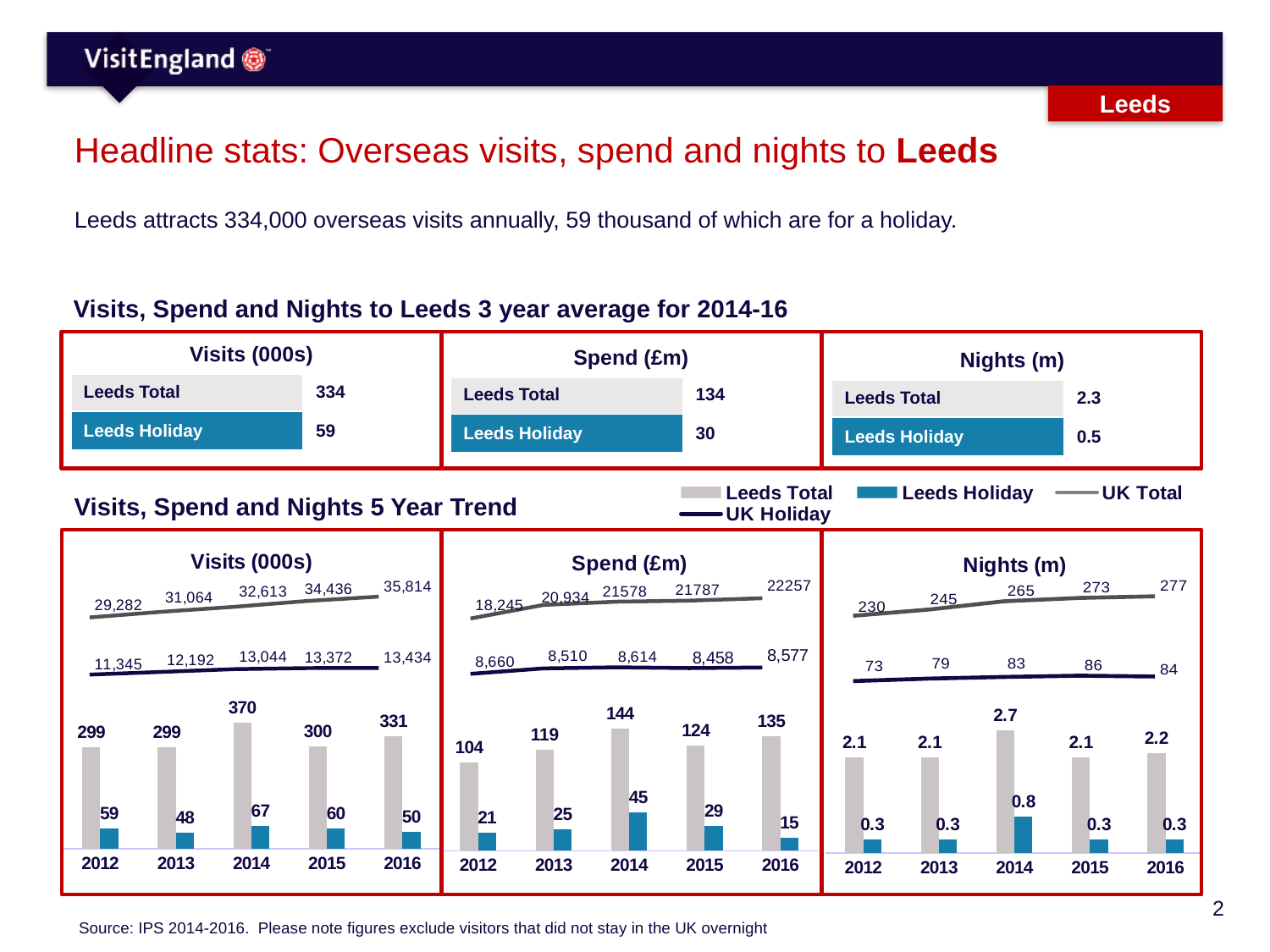
In the Visits (000s) trend chart, what is the Leeds Total value for 2014? 370 In the Nights (m) trend chart, what is the UK Holiday value for 2012? 73 In the Nights (m) trend chart, what is the UK Total value for 2015? 273 What kind of chart is used for the Leeds Total and Leeds Holiday series in the Spend (£m) trend chart? Bar chart How many years are shown on the x axis of the Visits (000s) trend chart? 5 In the Visits (000s) trend chart, which year has the lowest Leeds Holiday visits? 2013 In the Visits (000s) trend chart, does the UK Total line rise or fall from 2012 to 2016? Rise In the Spend (£m) trend chart, which year has the highest Leeds Total spend? 2014 In the Spend (£m) trend chart, what is the Leeds Holiday value for 2016? 15 How many series does the legend for the 5 Year Trend charts list? 4 In the Spend (£m) trend chart, what is the difference between the Leeds Total values for 2014 and 2012? 40 In the Nights (m) trend chart, is the Leeds Holiday value larger in 2014 or in 2015? 2014